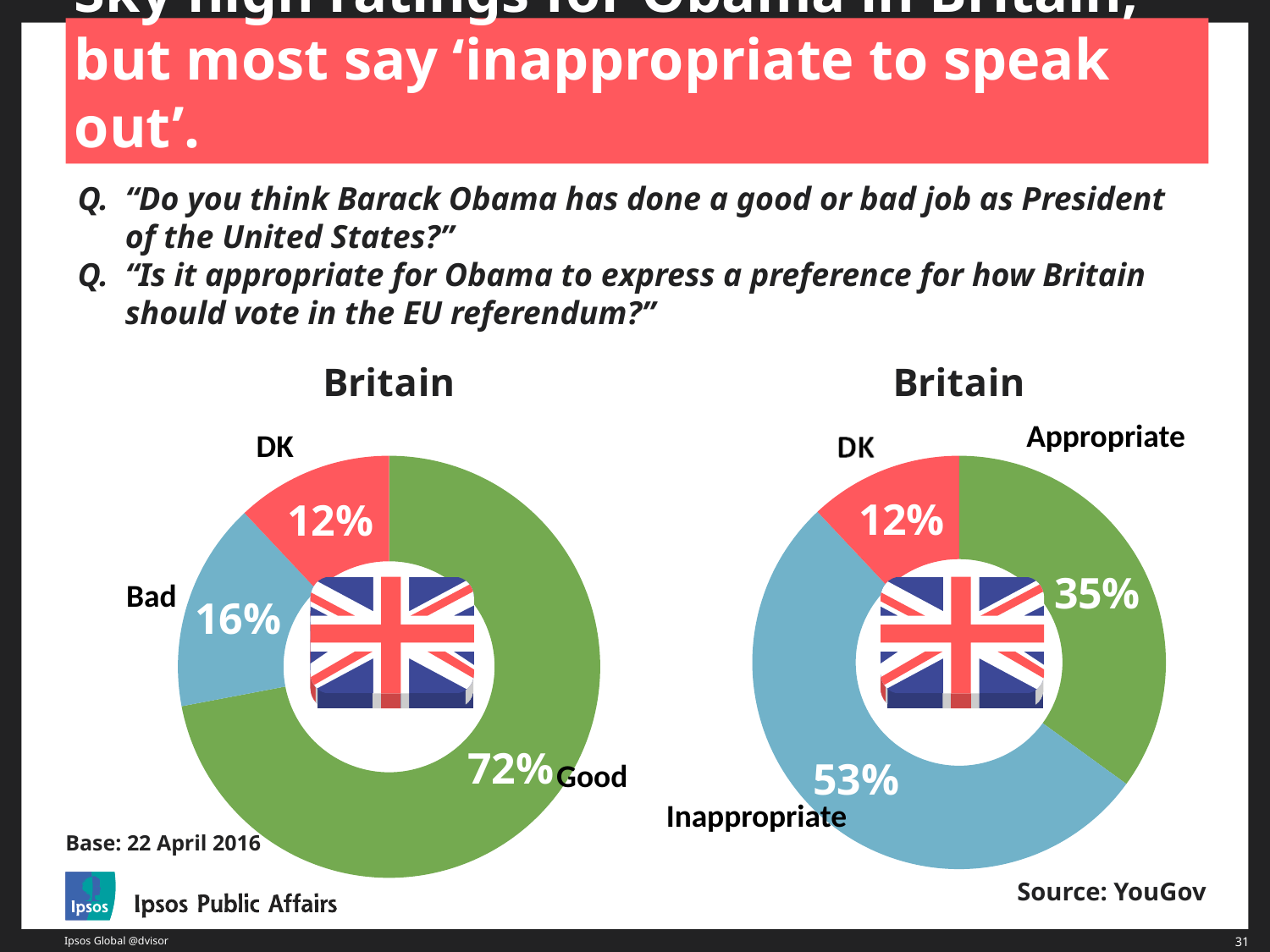
In the left-hand chart, what percentage say Obama has done a bad job? 16% In the left-hand chart, which category has the largest share? Good What is the DK share in the right-hand chart? 12% In the right-hand chart, what percentage say it is inappropriate for Obama to express a preference? 53% In the right-hand chart, what percentage say it is appropriate? 35% How many categories does the left-hand chart show? 3 What kind of chart is used on this slide? Pie (donut) chart In the right-hand chart, which category has the smallest share? DK In the left-hand chart, what is the difference in percentage points between Good and Bad? 56 In the right-hand chart, what is the difference in percentage points between Inappropriate and Appropriate? 18 In the right-hand chart, which is larger, Appropriate or Inappropriate? Inappropriate In the left-hand chart, what percentage say Obama has done a good job? 72%